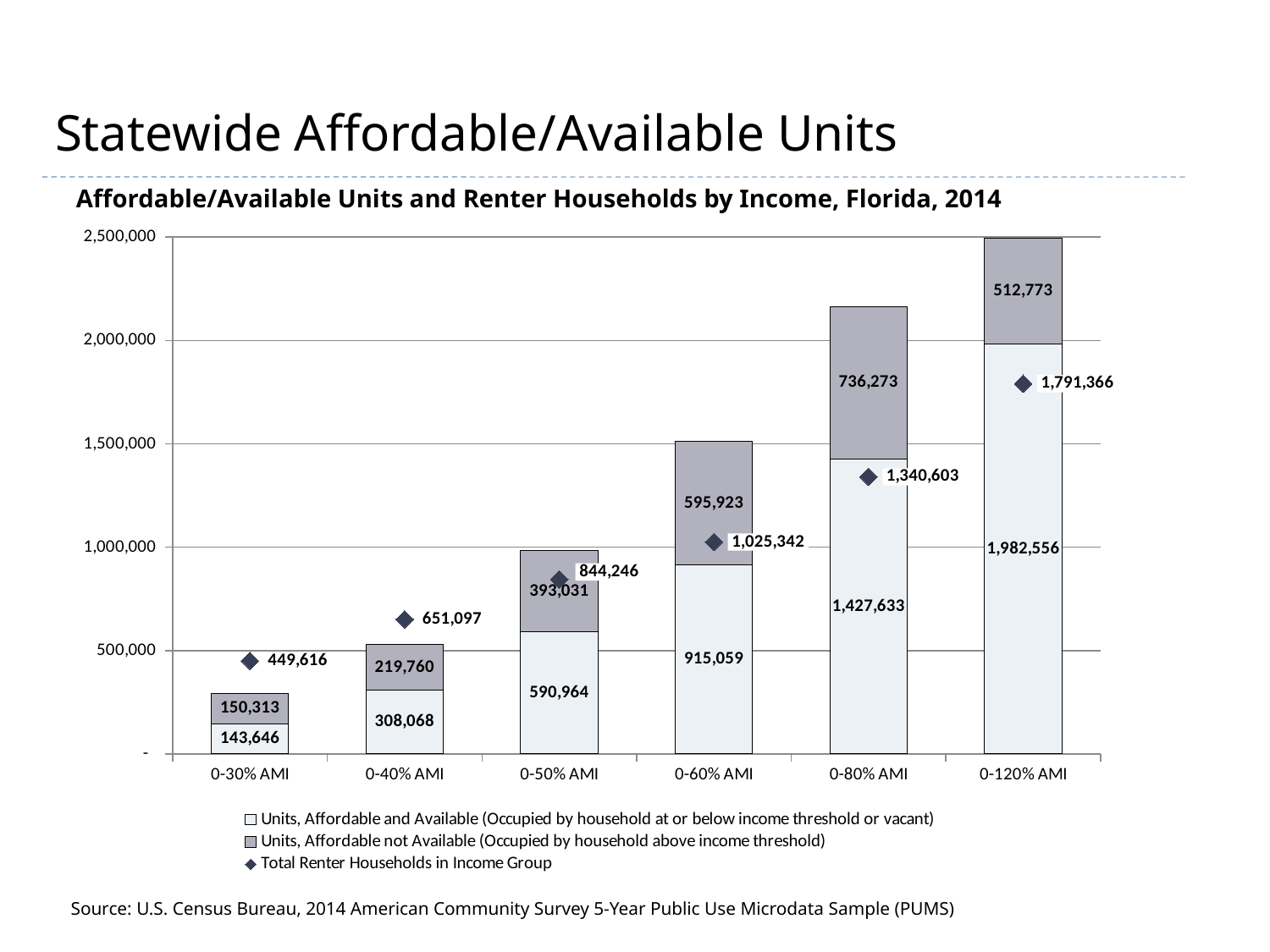
What is the value of Units, Affordable not Available for 0-40% AMI? 219,760 What is the title of the chart? Affordable/Available Units and Renter Households by Income, Florida, 2014 What is the total of the stacked bar for 0-30% AMI? 293,959 Which is larger for 0-120% AMI: Units, Affordable and Available or Total Renter Households in Income Group? Units, Affordable and Available What is the Total Renter Households in Income Group value for 0-80% AMI? 1,340,603 What kind of chart is this? Stacked bar chart with markers Which income group has the lowest value for Units, Affordable and Available? 0-30% AMI What is the difference between the Units, Affordable not Available values for 0-80% AMI and 0-120% AMI? 223,500 How many series does the legend list? 3 Which income group has the highest value for Units, Affordable not Available? 0-80% AMI What is the value of Units, Affordable and Available for 0-60% AMI? 915,059 How many income groups are shown on the x axis? 6